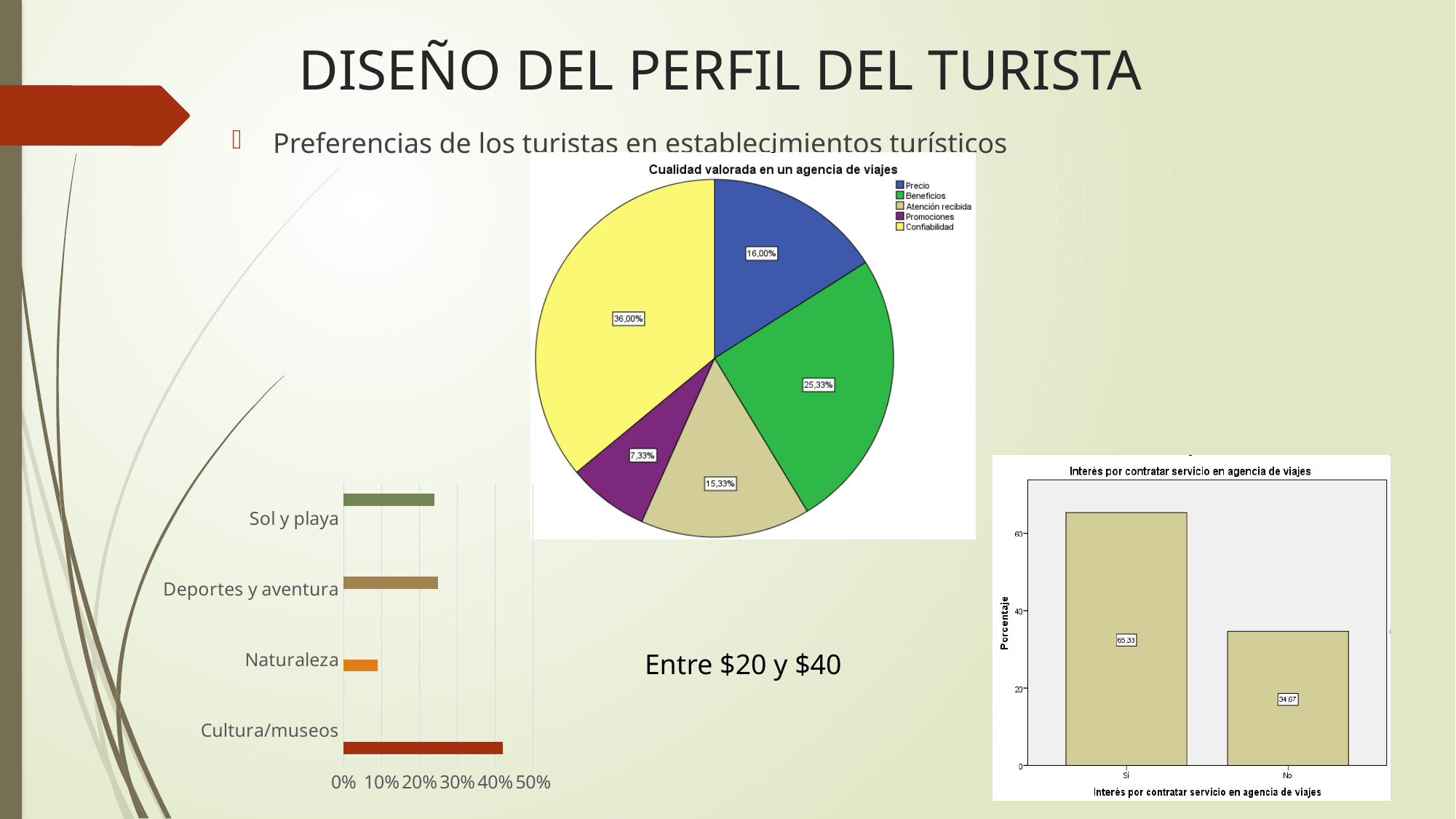
In the pie chart 'Cualidad valorada en un agencia de viajes', what percentage is shown for Confiabilidad? 36,00% In the pie chart 'Cualidad valorada en un agencia de viajes', which quality has the smallest share? Promociones What kind of chart is 'Interés por contratar servicio en agencia de viajes'? Bar chart In the pie chart 'Cualidad valorada en un agencia de viajes', what is the difference between the shares for Beneficios and Atención recibida? 10,00% In the horizontal bar chart at the bottom left of the slide, which category has the longest bar? Cultura/museos In the pie chart 'Cualidad valorada en un agencia de viajes', what percentage is shown for Precio? 16,00% In the chart 'Interés por contratar servicio en agencia de viajes', what is the difference between the values for Sí and No? 30,66 In the chart 'Interés por contratar servicio en agencia de viajes', what value is shown for No? 34,67 In the chart 'Interés por contratar servicio en agencia de viajes', what value is shown for Sí? 65,33 In the pie chart 'Cualidad valorada en un agencia de viajes', which quality has the largest share? Confiabilidad In the horizontal bar chart at the bottom left of the slide, is the value for Cultura/museos greater or less than 30%? greater How many entries does the legend of the pie chart 'Cualidad valorada en un agencia de viajes' list? 5